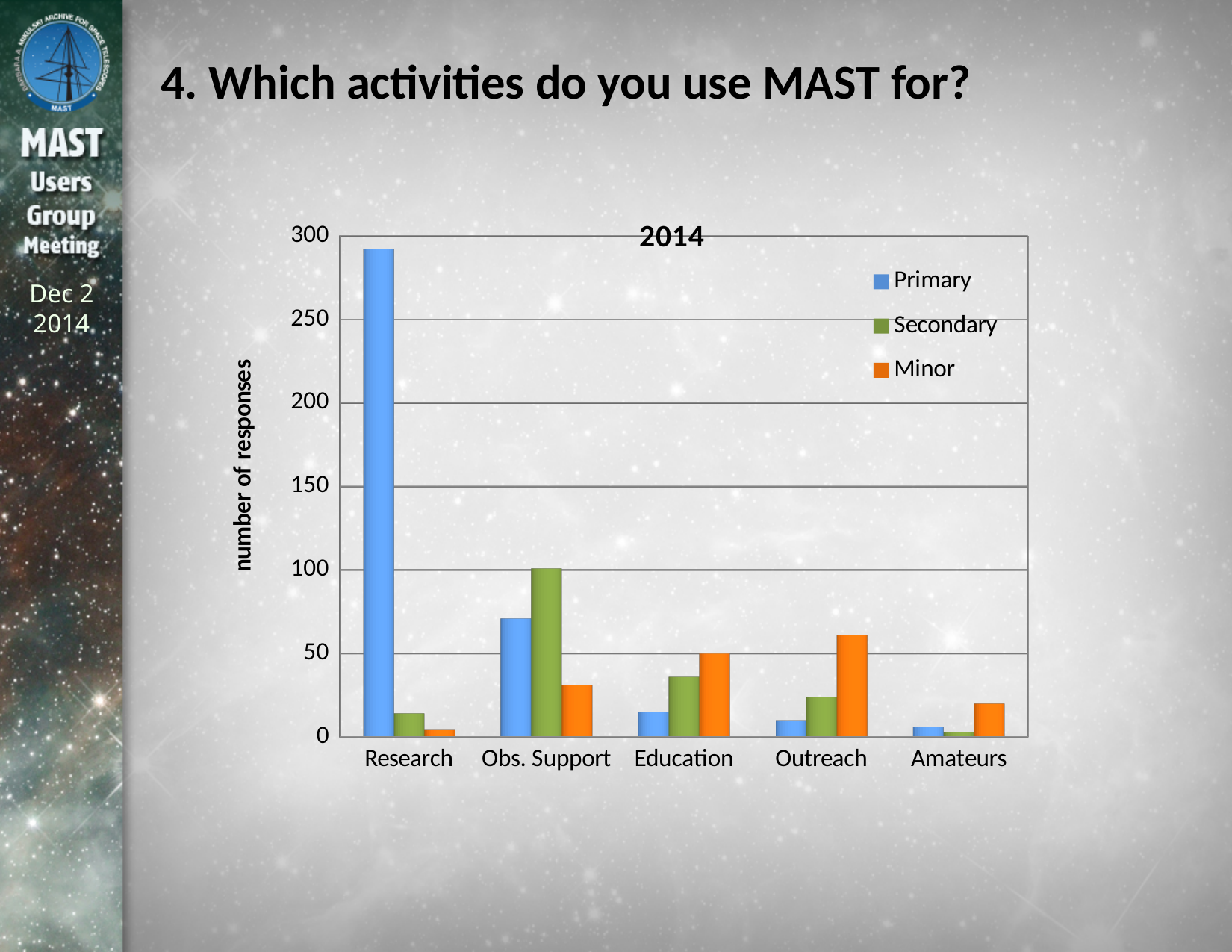
Which category has the highest Primary value? Research Which category has the highest Minor value? Outreach Is the Minor value for Amateurs greater or less than 50? less Is the Primary value for Research greater or less than 250? greater Do the Primary values rise or fall from Research to Amateurs along the x axis? fall How many activity categories are shown on the x axis? 5 What is the label on the y axis of the chart? number of responses How many series does the legend list? 3 What kind of chart is shown on the slide? bar chart For Obs. Support, which is larger: the Primary value or the Secondary value? Secondary Which category has the lowest Primary value? Amateurs Which category has the highest Secondary value? Obs. Support